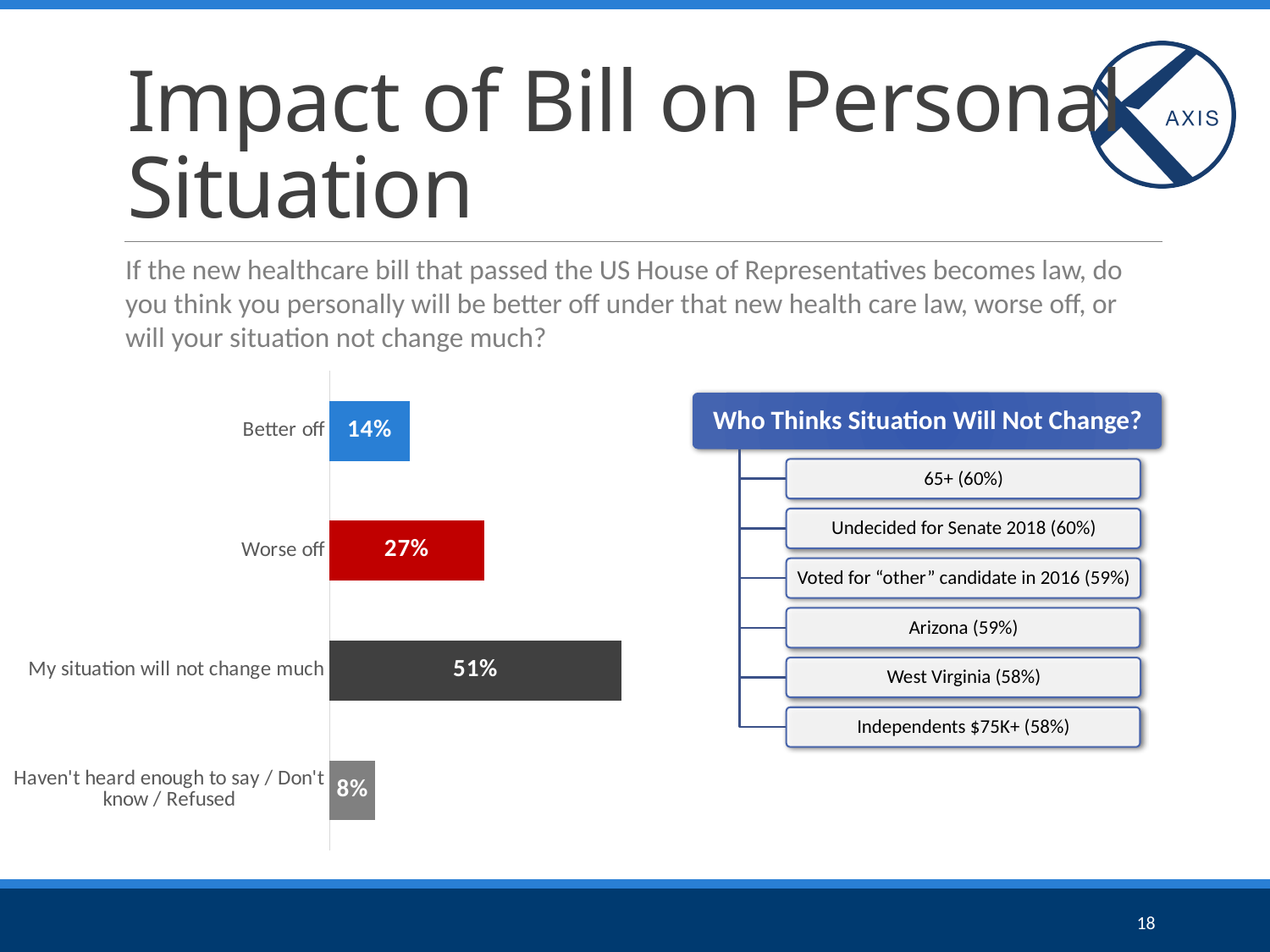
What is the difference in percentage points between 'My situation will not change much' and 'Worse off'? 24 Which response category has the lowest percentage? Haven't heard enough to say / Don't know / Refused What is the difference in percentage points between 'Worse off' and 'Better off'? 13 What percentage of respondents said they would be worse off? 27% What type of chart is used to show the responses? Bar chart What percentage of respondents answered 'Haven't heard enough to say / Don't know / Refused'? 8% What colour is the bar for 'Worse off'? Red Which response category has the highest percentage? My situation will not change much How many response categories are shown in the bar chart? 4 What percentage of respondents said they would be better off? 14% What percentage of respondents said their situation will not change much? 51% Which is larger, the percentage for 'Worse off' or for 'Better off'? Worse off